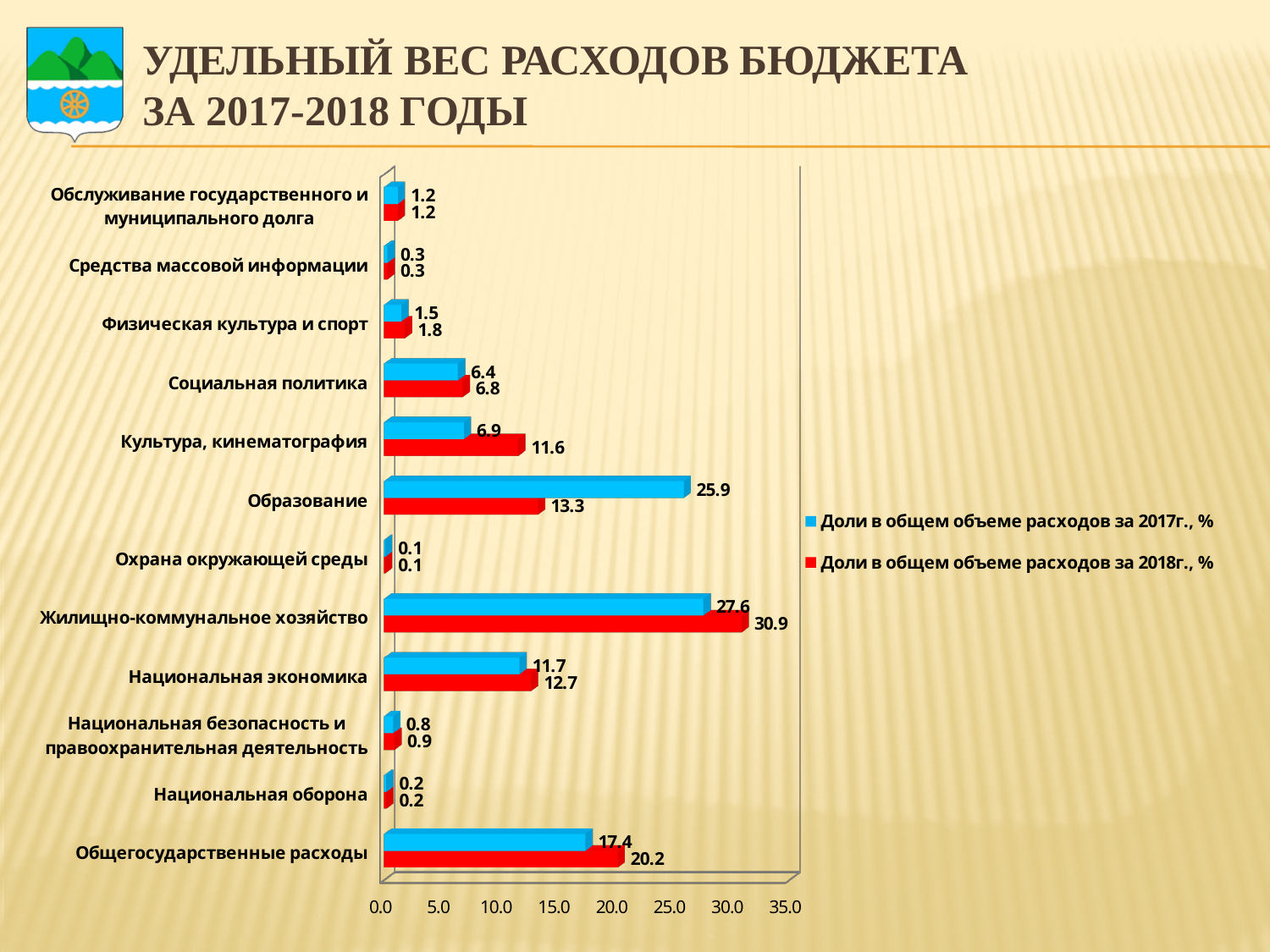
How many series does the legend list? 2 What is the 2017 share (Доли в общем объеме расходов за 2017г., %) for Образование? 25.9 What is the difference between the 2017 and 2018 shares for Образование? 12.6 Which category has the lowest 2017 share? Охрана окружающей среды What is the 2018 share for Культура, кинематография? 11.6 What is the 2018 share (Доли в общем объеме расходов за 2018г., %) for Жилищно-коммунальное хозяйство? 30.9 How many categories are shown on the chart? 12 What kind of chart is shown on the slide? Bar chart What is the 2017 share for Национальная экономика? 11.7 Which category has the highest 2018 share? Жилищно-коммунальное хозяйство Which colour represents the 2018 series (Доли в общем объеме расходов за 2018г., %)? Red Which is larger for Общегосударственные расходы: the 2017 share or the 2018 share? 2018 share